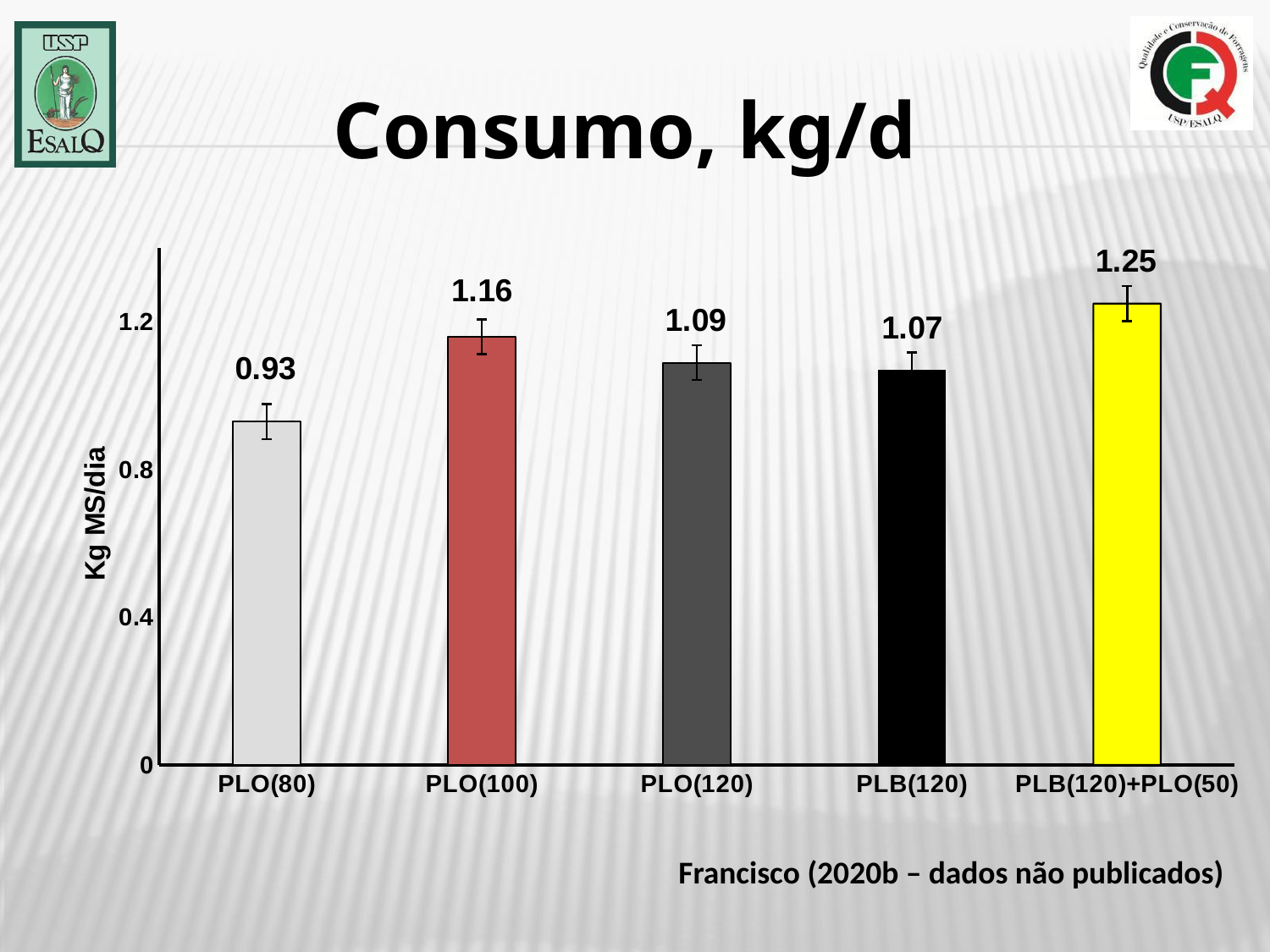
Which category has the lowest value? PLO(80) Is the value for PLB(120) greater or less than 0.8? greater Which category has the highest value? PLB(120)+PLO(50) What is the value for PLO(80)? 0.93 What is the value for PLB(120)+PLO(50)? 1.25 What kind of chart is shown on the slide? bar chart How many categories are shown on the x axis? 5 What is the value for PLO(120)? 1.09 What is the difference between the values for PLO(100) and PLO(80)? 0.23 What is the title of the slide's chart? Consumo, kg/d Which is larger, the value for PLO(100) or the value for PLB(120)? PLO(100) What is the label on the y axis? Kg MS/dia